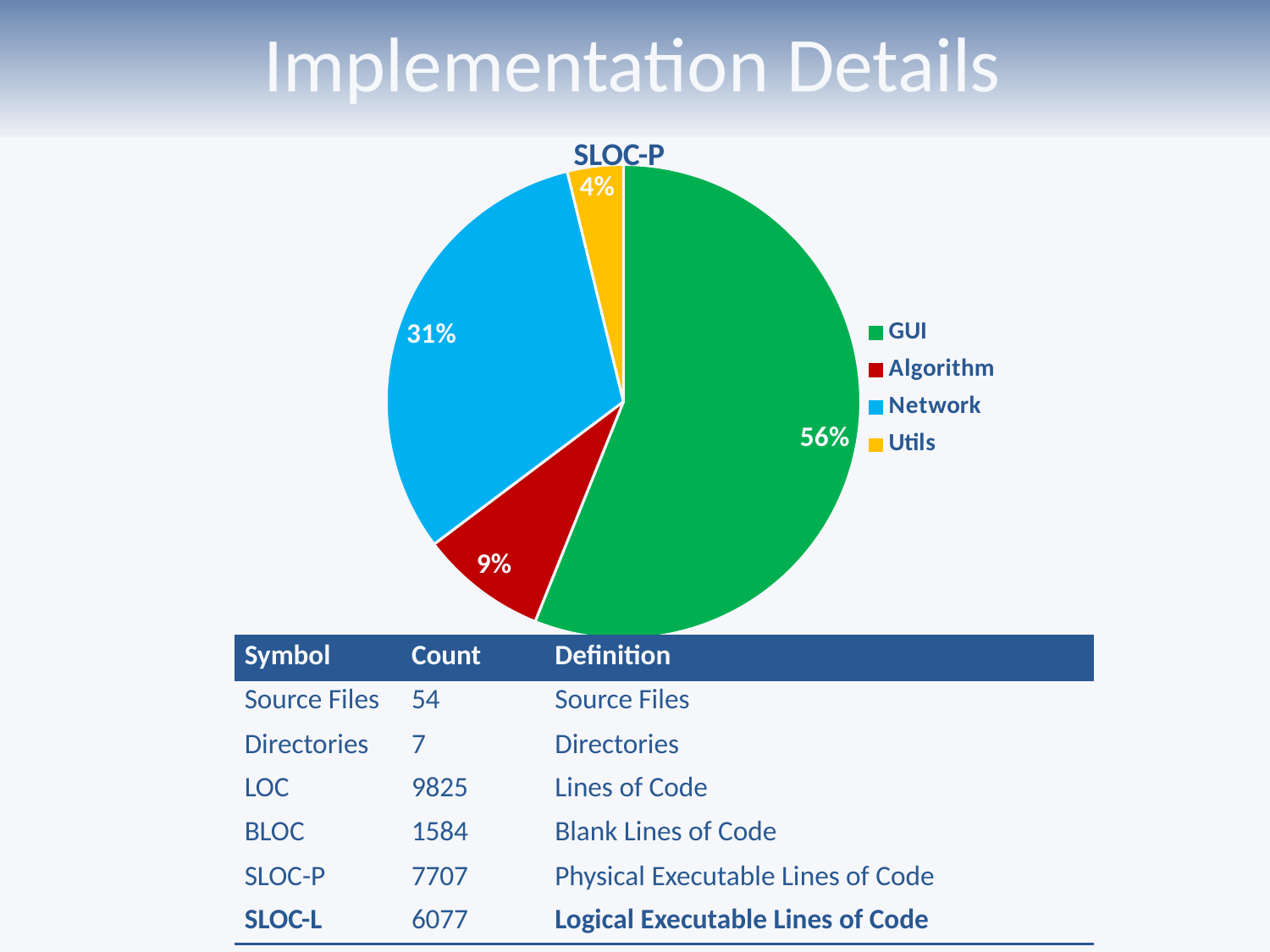
What is the title of the chart? SLOC-P What colour is the Network slice in the pie chart? Light blue Which category has the largest slice in the SLOC-P pie chart? GUI Which category has the smallest slice in the SLOC-P pie chart? Utils What kind of chart is shown on the slide? Pie chart What share of the SLOC-P pie does GUI account for? 56% How many categories are shown in the SLOC-P pie chart? 4 What share of the SLOC-P pie does Algorithm account for? 9% Which slice is larger, Algorithm or Network? Network What is the difference in percentage points between the GUI and Network slices? 25% What share of the SLOC-P pie does Network account for? 31%